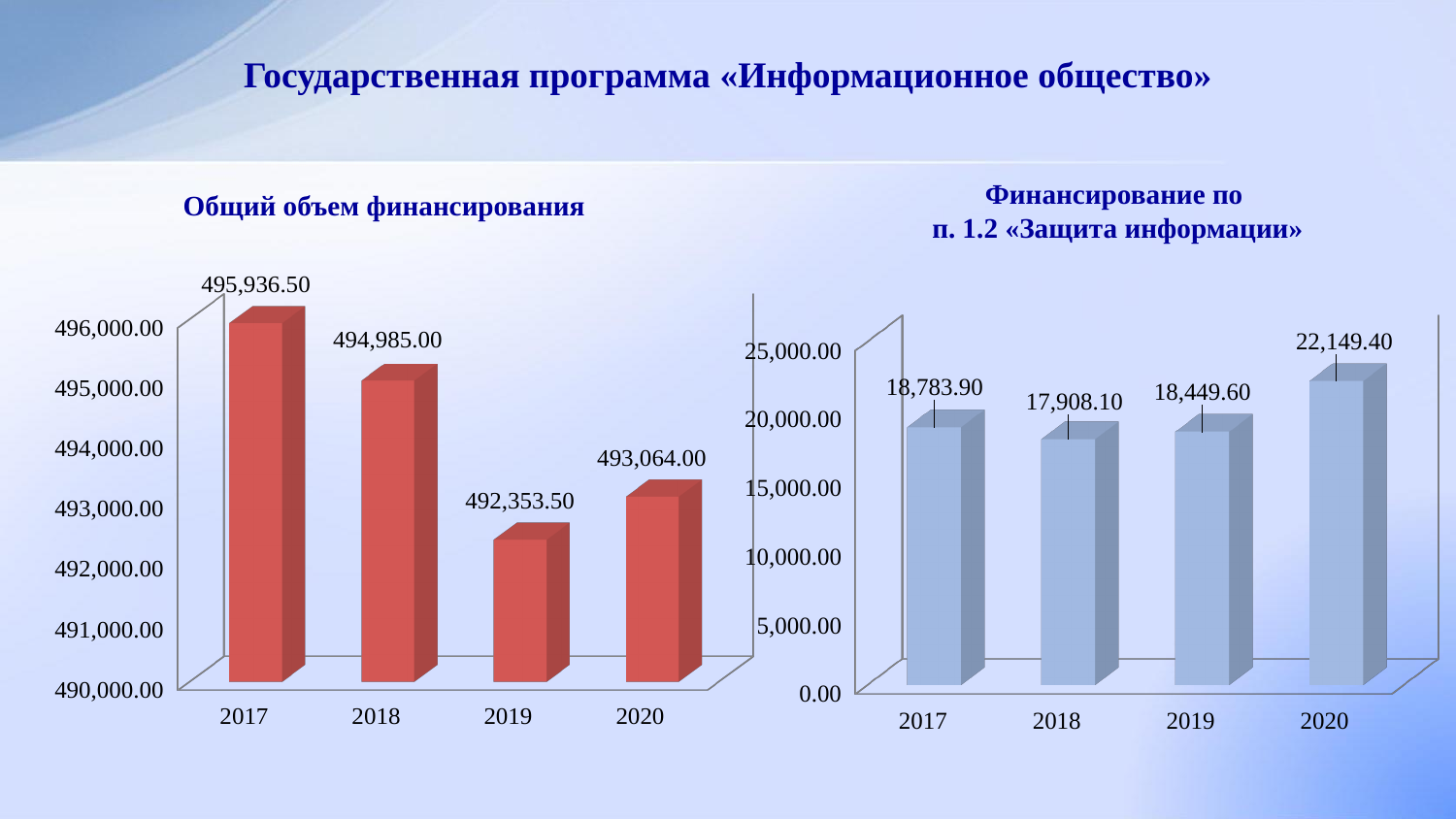
In the chart titled «Общий объем финансирования», what is the value for 2019? 492,353.50 In the chart titled «Общий объем финансирования», which is larger, the value for 2019 or the value for 2020? 2020 In the chart titled «Общий объем финансирования», what is the difference between the 2017 and 2018 values? 951.50 In the chart titled «Финансирование по п. 1.2 «Защита информации»», which year has the highest value? 2020 In the chart titled «Общий объем финансирования», which year has the lowest value? 2019 In the chart titled «Финансирование по п. 1.2 «Защита информации»», what is the value for 2020? 22,149.40 In the chart titled «Финансирование по п. 1.2 «Защита информации»», what is the difference between the 2020 and 2017 values? 3,365.50 In the chart titled «Финансирование по п. 1.2 «Защита информации»», is the value for 2019 greater or less than 20,000.00? less How many years are shown on the x axis of the chart titled «Общий объем финансирования»? 4 What kind of chart is the chart titled «Финансирование по п. 1.2 «Защита информации»»? bar chart In the chart titled «Общий объем финансирования», what is the value for 2017? 495,936.50 In the chart titled «Финансирование по п. 1.2 «Защита информации»», what is the value for 2018? 17,908.10